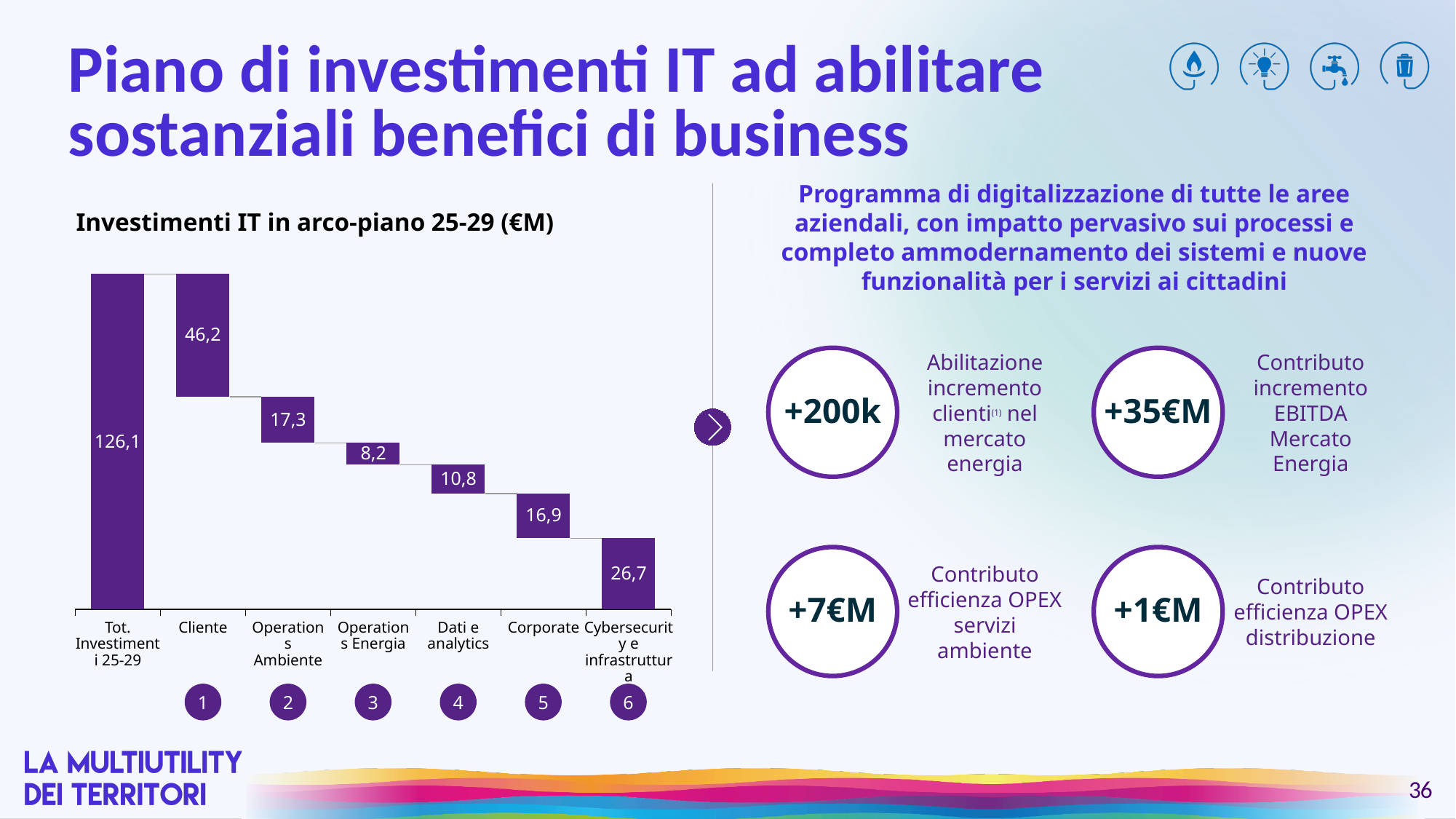
What is the value for Operations Energia in the chart? 8,2 Which category has the lowest investment value in the chart? Operations Energia What is the value of the Tot. Investimenti 25-29 bar? 126,1 How many categories are shown on the x axis of the chart, including the total? 7 Excluding the total bar, which category has the highest investment value? Cliente What is the difference between the values for Dati e analytics and Operations Energia? 2,6 What is the title of the chart on the left of the slide? Investimenti IT in arco-piano 25-29 (€M) Which is larger, the value for Corporate or the value for Operations Ambiente? Operations Ambiente What is the difference between the values for Cliente and Cybersecurity e infrastruttura? 19,5 What is the value for Cybersecurity e infrastruttura in the chart? 26,7 What kind of chart is 'Investimenti IT in arco-piano 25-29 (€M)'? Bar chart (waterfall) What is the value for Cliente in the chart 'Investimenti IT in arco-piano 25-29 (€M)'? 46,2